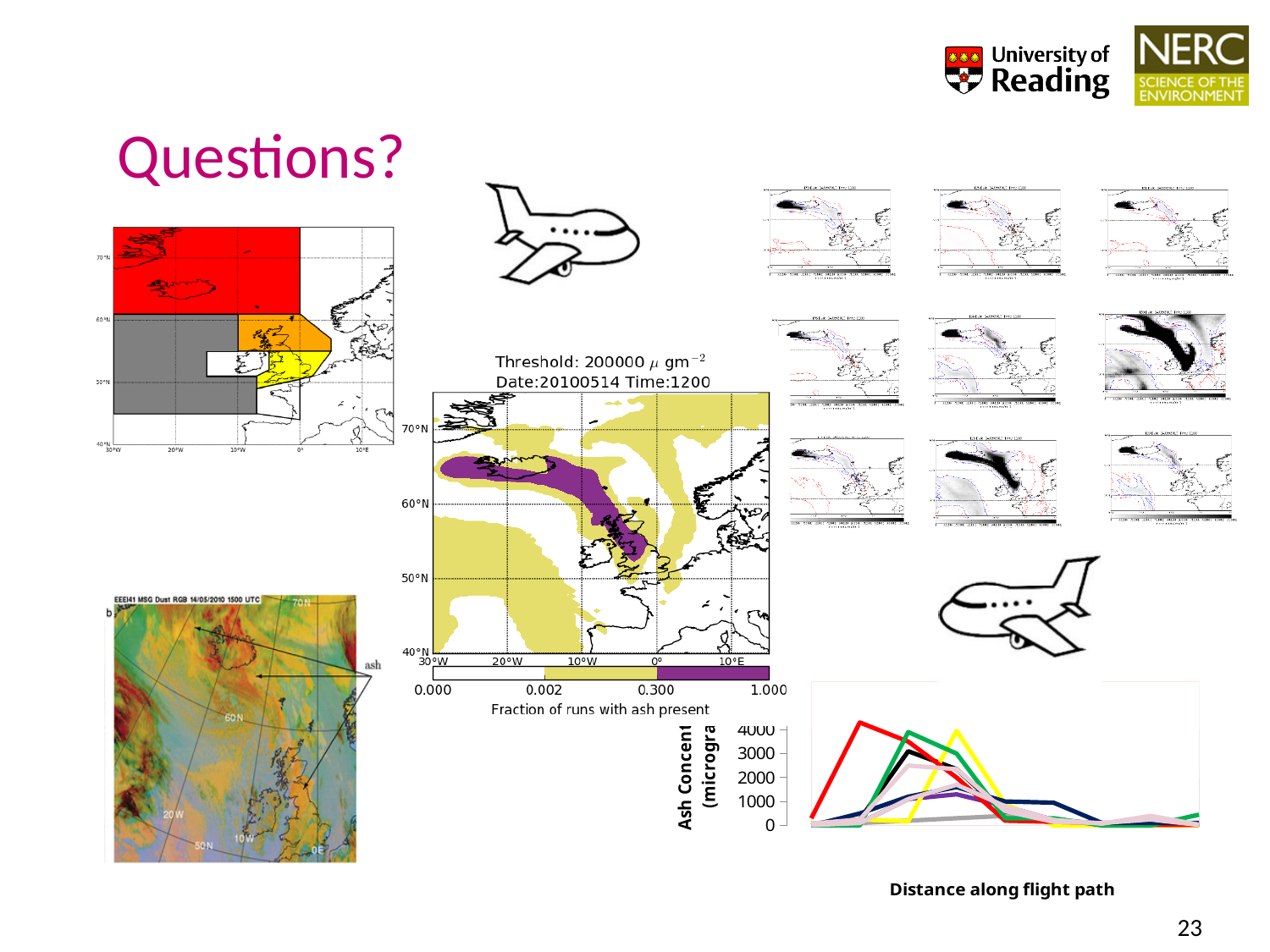
In the line chart at the bottom right, which line reaches a higher peak, the dark blue line or the green line? the green line In the line chart at the bottom right, is the peak value of the grey line greater or less than 1000? less In the line chart at the bottom right, is the peak value of the red line greater or less than 3000? greater In the line chart at the bottom right, is the peak value of the green line greater or less than 2000? greater In the line chart at the bottom right, what is the highest tick value shown on the y axis? 4000 In the line chart at the bottom right, do the values of the red line rise or fall after its peak as distance along the flight path increases? fall In the line chart at the bottom right, which line reaches a higher peak, the red line or the grey line? the red line In the line chart at the bottom right, what is the label of the x axis? Distance along flight path What kind of chart is the one at the bottom right of the slide with the x axis 'Distance along flight path'? line chart